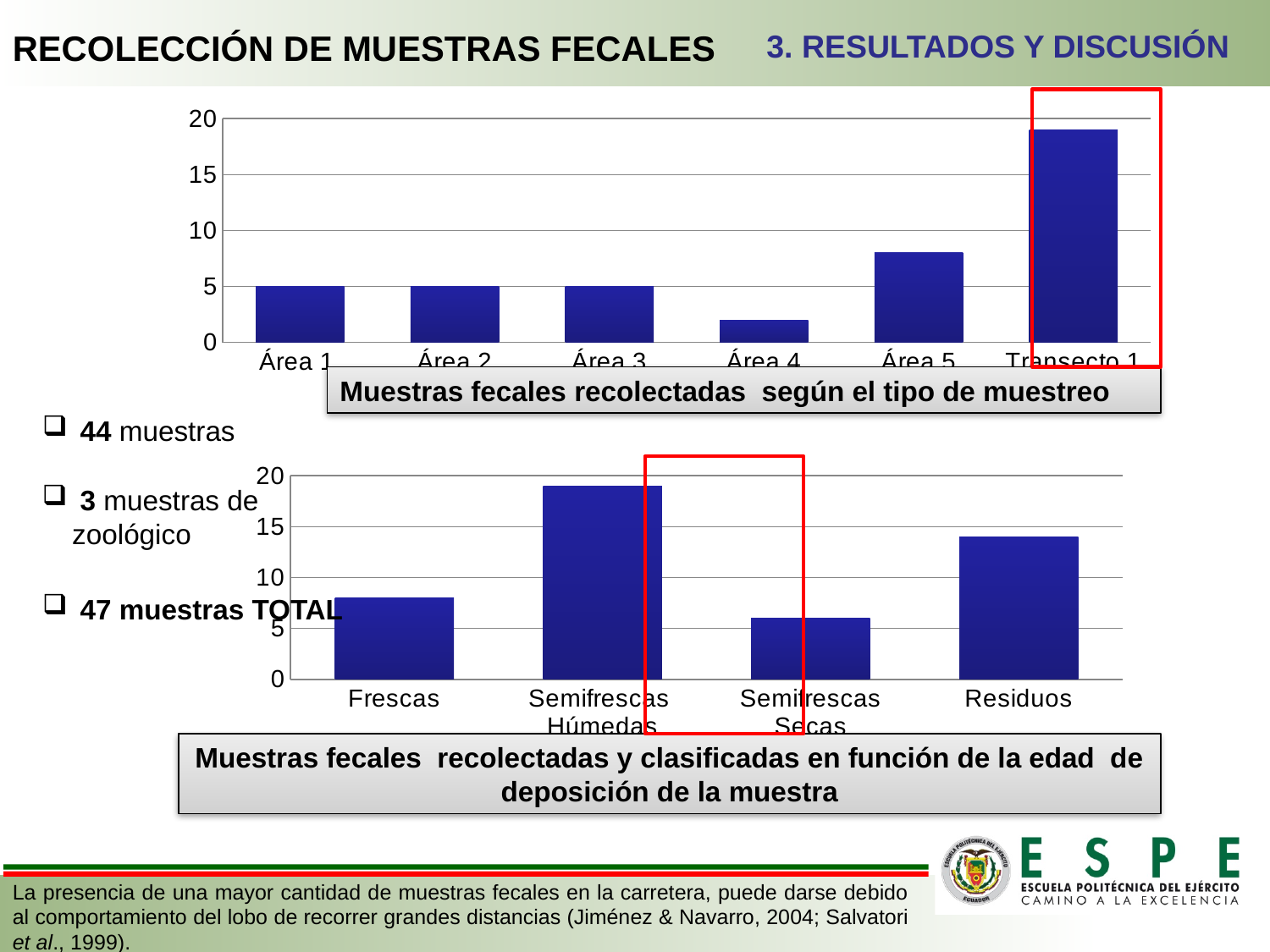
In the top chart (Muestras fecales recolectadas según el tipo de muestreo), which category has the highest value? Transecto 1 In the top chart (Muestras fecales recolectadas según el tipo de muestreo), what kind of chart is shown? bar chart In the bottom chart (Muestras fecales recolectadas y clasificadas en función de la edad de deposición de la muestra), how many categories are plotted? 4 In the bottom chart (Muestras fecales recolectadas y clasificadas en función de la edad de deposición de la muestra), which category has the highest value? Semifrescas Húmedas In the bottom chart (Muestras fecales recolectadas y clasificadas en función de la edad de deposición de la muestra), is the value for Residuos greater or less than 10? greater In the top chart (Muestras fecales recolectadas según el tipo de muestreo), which category has the lowest value? Área 4 In the top chart (Muestras fecales recolectadas según el tipo de muestreo), is the value for Área 5 greater or less than 10? less In the top chart (Muestras fecales recolectadas según el tipo de muestreo), is the value for Transecto 1 greater or less than 15? greater In the bottom chart (Muestras fecales recolectadas y clasificadas en función de la edad de deposición de la muestra), which category has the lowest value? Semifrescas Secas In the top chart (Muestras fecales recolectadas según el tipo de muestreo), what is the value for Área 1? 5 In the top chart (Muestras fecales recolectadas según el tipo de muestreo), how many categories are plotted? 6 In the bottom chart (Muestras fecales recolectadas y clasificadas en función de la edad de deposición de la muestra), which is larger, Frescas or Residuos? Residuos